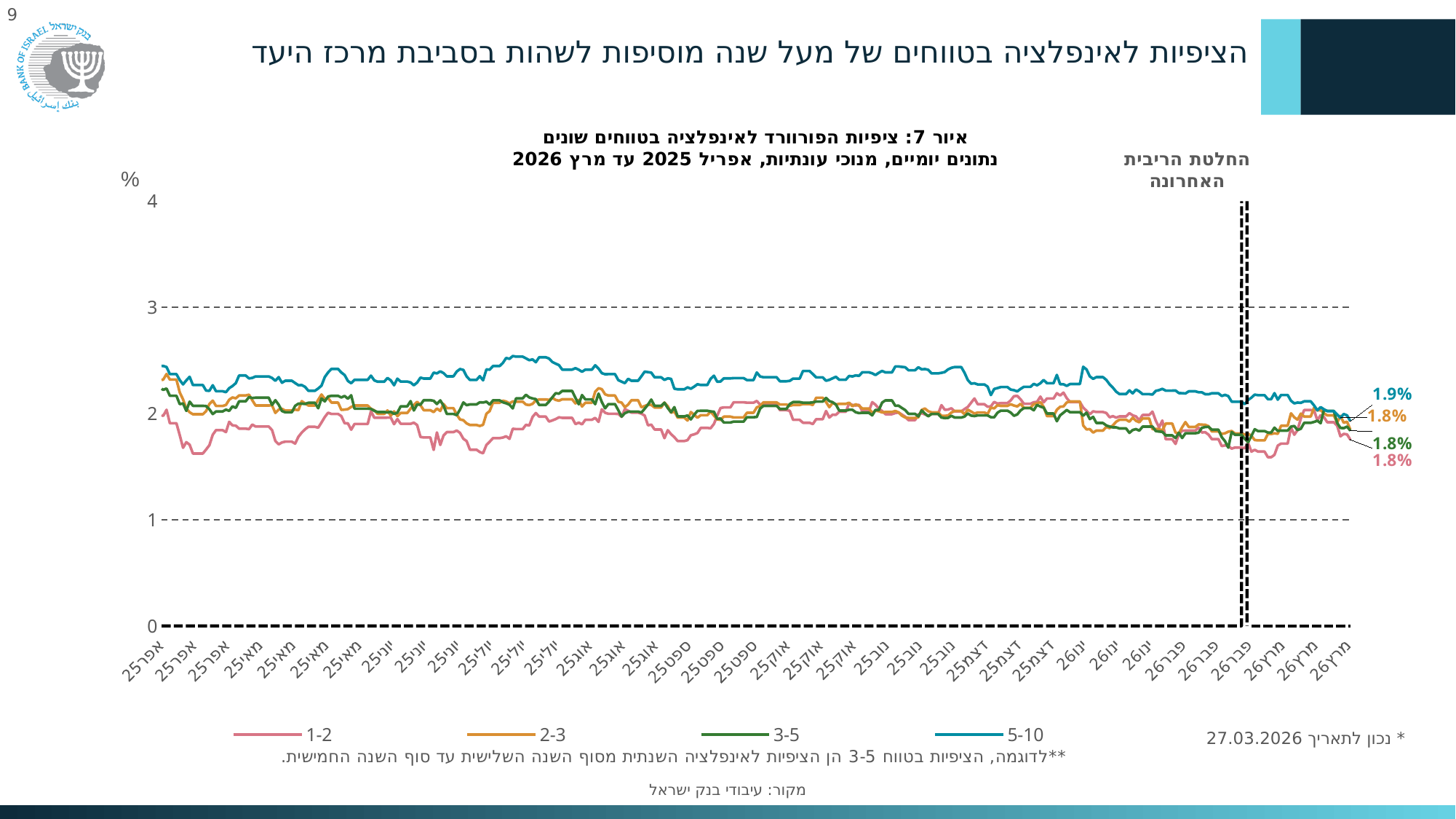
Is the value of the 5-10 series at any point greater or less than 3? less What is the final labelled value of the 5-10 series? 1.9% What is the final labelled value of the 2-3 series? 1.8% How many series does the legend list? 4 What does the vertical dashed line near the right of the chart mark, according to its label? החלטת הריבית האחרונה What is the final labelled value of the 1-2 series? 1.8% At the start of the period (April 2025), is the value of the 5-10 series greater or less than 2? greater What is the difference between the final labelled values of the 5-10 series and the 1-2 series? 0.1% Does the 5-10 series rise or fall overall from April 2025 to March 2026? fall At the end of the period, which is larger: the labelled value of the 5-10 series or the 3-5 series? 5-10 Which series has the highest labelled value at the end of the period? 5-10 What kind of chart is shown on the slide? line chart